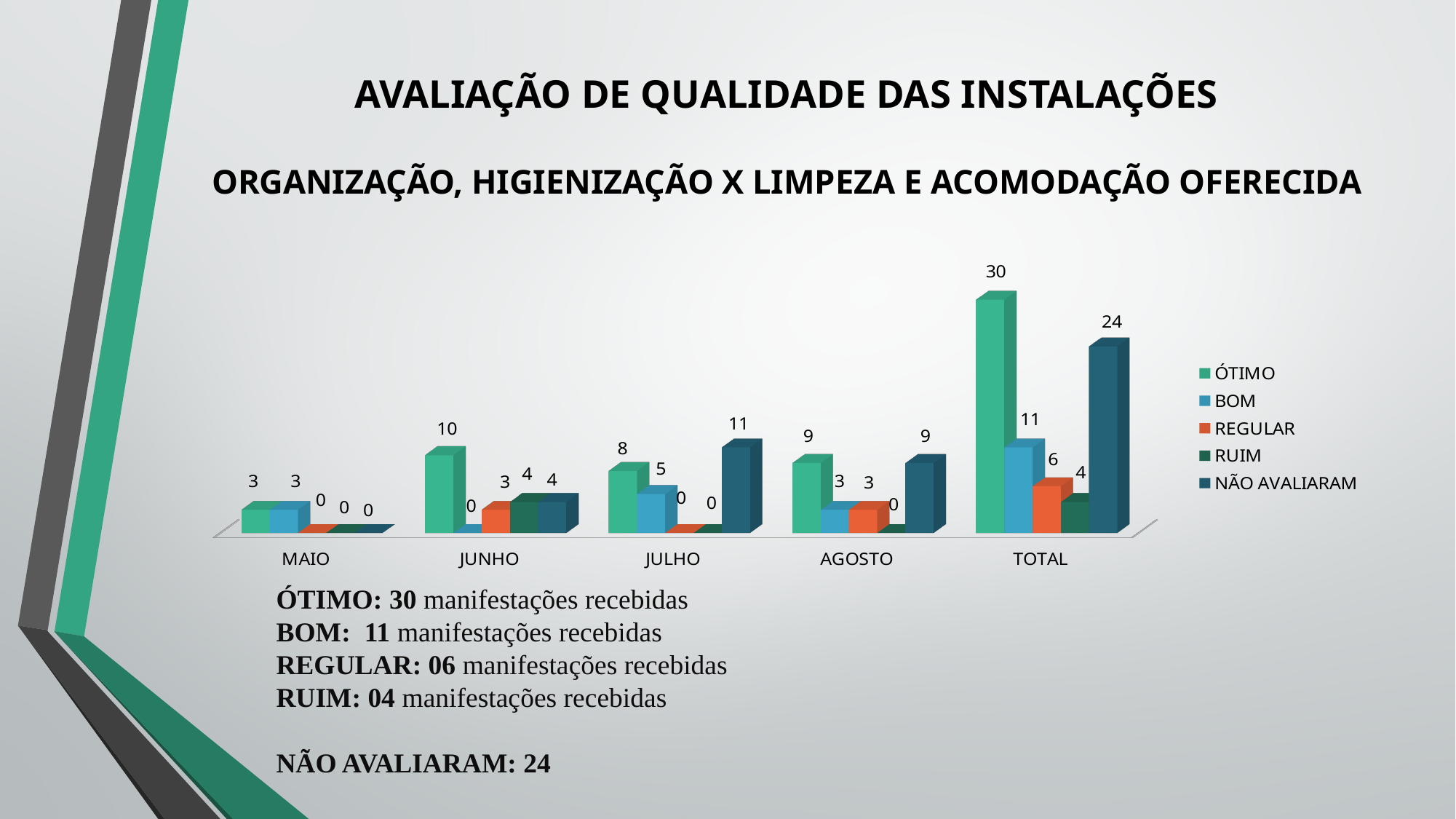
What is the value for REGULAR in AGOSTO? 3 What is the value for ÓTIMO in JUNHO? 10 What is the value for BOM in TOTAL? 11 Which month has the highest value for ÓTIMO, excluding TOTAL? JUNHO What kind of chart is shown on the slide? bar chart Which is larger in JULHO: ÓTIMO or NÃO AVALIARAM? NÃO AVALIARAM Which series has the lowest value in the TOTAL category? RUIM Which legend entry is shown in orange? REGULAR What is the difference between ÓTIMO and NÃO AVALIARAM in the TOTAL category? 6 How many series does the legend list? 5 How many categories are shown on the x axis? 5 What is the value for NÃO AVALIARAM in JULHO? 11